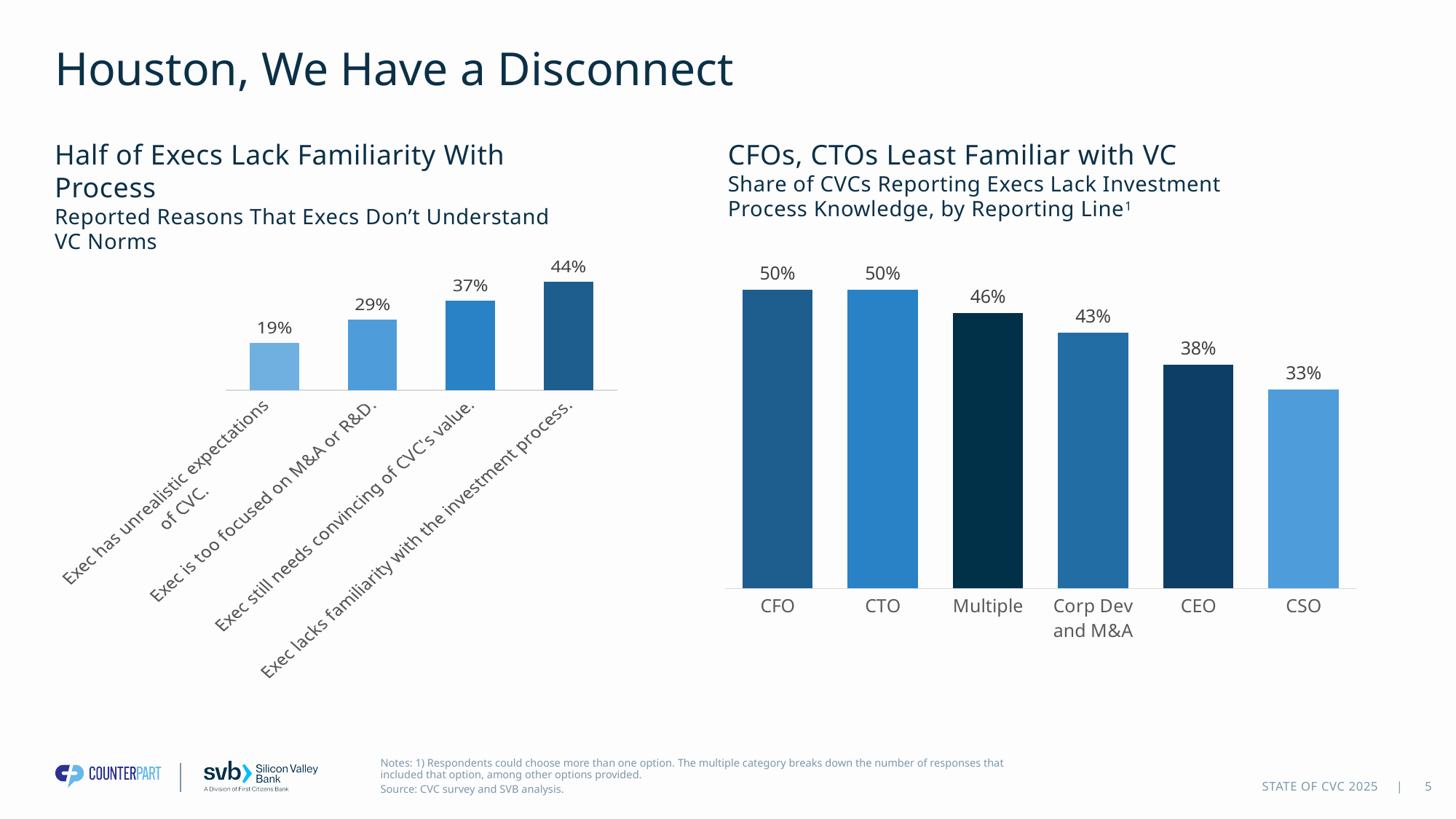
In the left chart (Half of Execs Lack Familiarity With Process), which reason has the lowest value? Exec has unrealistic expectations of CVC. In the left chart (Half of Execs Lack Familiarity With Process), what is the difference between "Exec still needs convincing of CVC's value." and "Exec has unrealistic expectations of CVC."? 18% In the left chart (Half of Execs Lack Familiarity With Process), do the values rise or fall from left to right? rise In the right chart (CFOs, CTOs Least Familiar with VC), what is the value for Corp Dev and M&A? 43% What kind of chart is the right chart (CFOs, CTOs Least Familiar with VC)? bar chart In the left chart (Half of Execs Lack Familiarity With Process), what is the value for "Exec is too focused on M&A or R&D."? 29% In the right chart (CFOs, CTOs Least Familiar with VC), what is the value for CEO? 38% In the right chart (CFOs, CTOs Least Familiar with VC), which is larger, Multiple or CEO? Multiple In the left chart (Half of Execs Lack Familiarity With Process), how many reasons are plotted? 4 In the left chart (Half of Execs Lack Familiarity With Process), what is the value for "Exec lacks familiarity with the investment process."? 44% In the right chart (CFOs, CTOs Least Familiar with VC), what is the difference between CFO and CSO? 17% In the right chart (CFOs, CTOs Least Familiar with VC), which reporting line has the lowest value? CSO